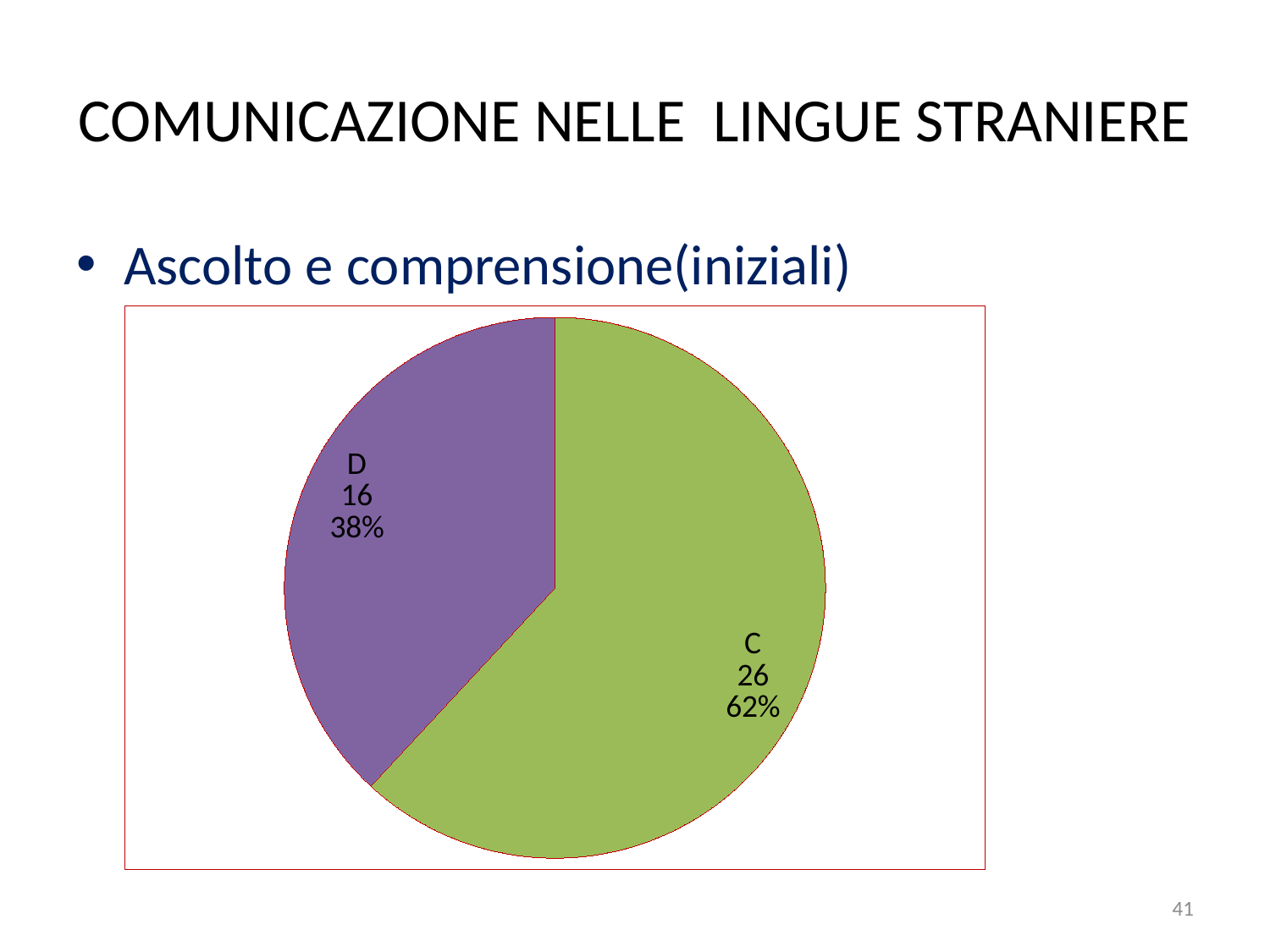
What is the difference between the values of C and D? 10 What share of the pie does slice D represent? 38% What share of the pie does slice C represent? 62% What colour is the slice for C? green How many slices does the pie chart have? 2 Which slice is the largest? C What is the total of the two slice values? 42 Which is larger, the value for C or the value for D? C Which slice is the smallest? D What is the value for slice C? 26 What is the value for slice D? 16 What kind of chart is shown on the slide? pie chart